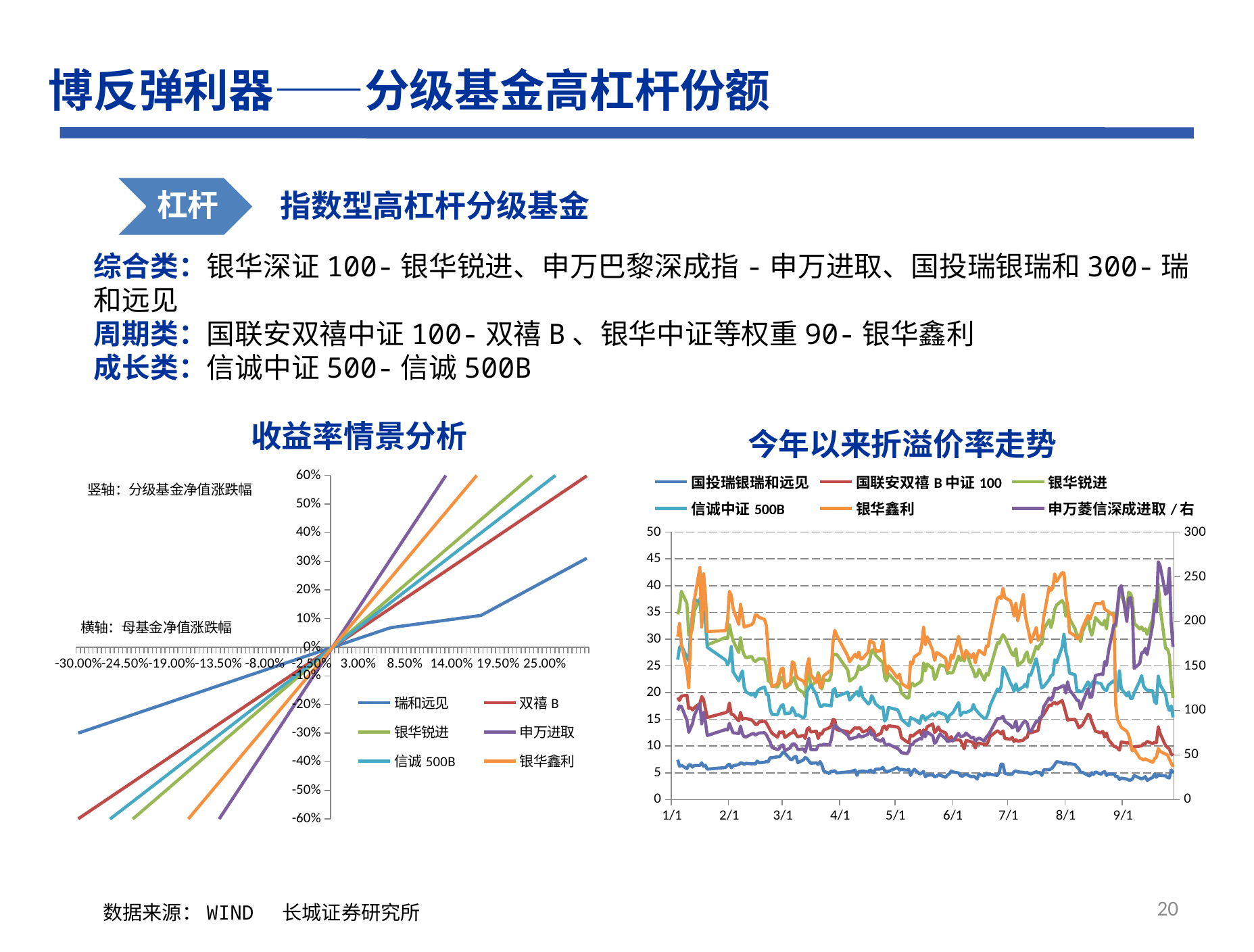
In the 今年以来折溢价率走势 chart, is the value for 国投瑞银瑞和远见 at 1/1 greater or less than 10? less How many series does the legend of the 收益率情景分析 chart list? 6 In the 今年以来折溢价率走势 chart, which series is plotted against the right-hand axis? 申万菱信深成进取/右 In the 收益率情景分析 chart, which series has the steepest line? 申万进取 What kind of chart is the 今年以来折溢价率走势 chart on the right? line chart In the 收益率情景分析 chart, which series has the flattest line (smallest change in fund NAV for a given change in the parent fund)? 瑞和远见 In the 今年以来折溢价率走势 chart, which series stays lowest on the left axis throughout the year? 国投瑞银瑞和远见 In the 收益率情景分析 chart, what is the highest value shown on the vertical axis? 60% In the 收益率情景分析 chart, what does the horizontal axis represent according to the label on the chart? 母基金净值涨跌幅 In the 今年以来折溢价率走势 chart, does the 国联安双禧B中证100 series rise or fall overall from 1/1 to 9/1? fall What kind of chart is the 收益率情景分析 chart on the left? line chart How many series does the legend of the 今年以来折溢价率走势 chart list? 6